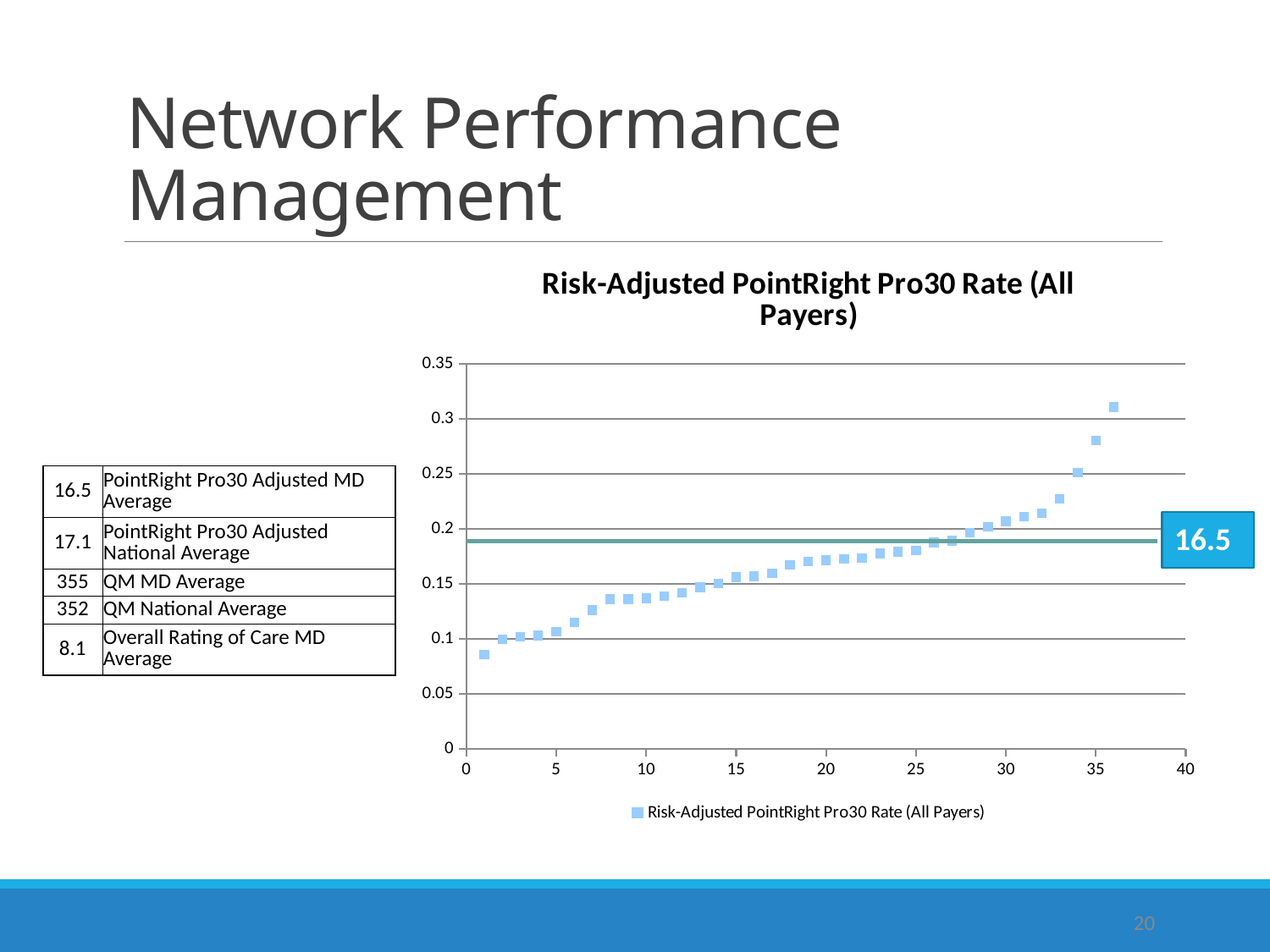
Do the plotted values rise or fall as you move from left to right along the x axis? rise What is the title of the chart? Risk-Adjusted PointRight Pro30 Rate (All Payers) Is the value of the point at x = 20 greater or less than 0.2? less What value is labelled on the horizontal reference line in the chart? 16.5 At which x position is the lowest plotted value found? 1 Is the value of the rightmost point (at x = 36) greater or less than 0.3? greater What is the name of the series listed in the chart legend? Risk-Adjusted PointRight Pro30 Rate (All Payers) Which point has the highest value: the one at x = 1 or the one at x = 36? x = 36 Is the value of the point at x = 35 greater or less than 0.25? greater How many series does the chart legend list? 1 What kind of chart is shown on the slide? scatter chart